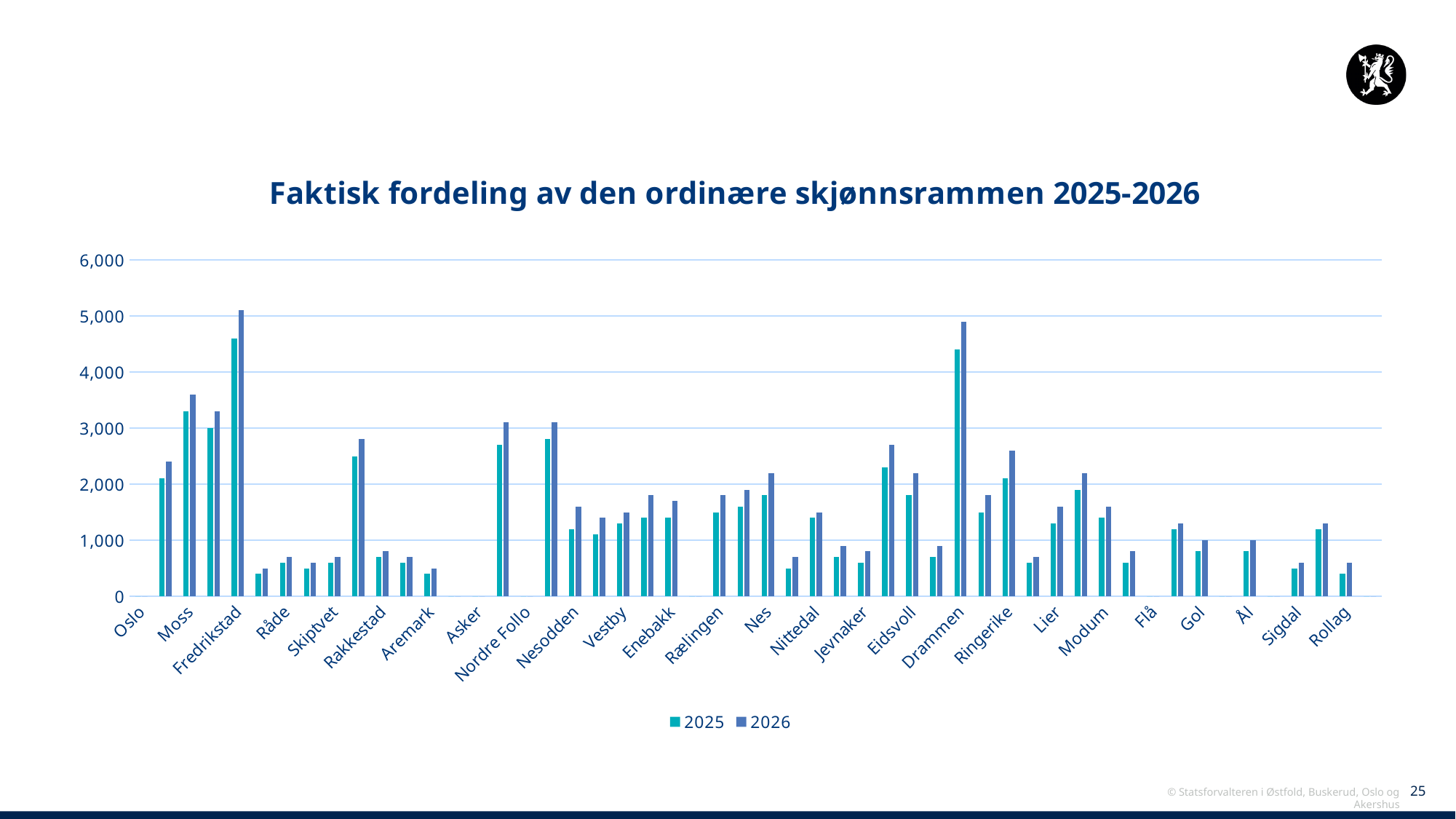
Which municipality has the highest 2026 value? Fredrikstad For each municipality, is the 2026 bar generally higher or lower than the 2025 bar? higher Is the 2025 value for Drammen greater or less than 4,000? greater Is the 2025 value for Råde greater or less than 1,000? less What is the title of the chart? Faktisk fordeling av den ordinære skjønnsrammen 2025-2026 What are the two series named in the legend? 2025 and 2026 Which municipality has the highest 2025 value? Fredrikstad Is the 2026 value for Moss greater or less than 3,000? greater How many series does the legend list? 2 Which is larger, the 2026 value for Fredrikstad or the 2026 value for Drammen? Fredrikstad What kind of chart is shown on the slide? Bar chart